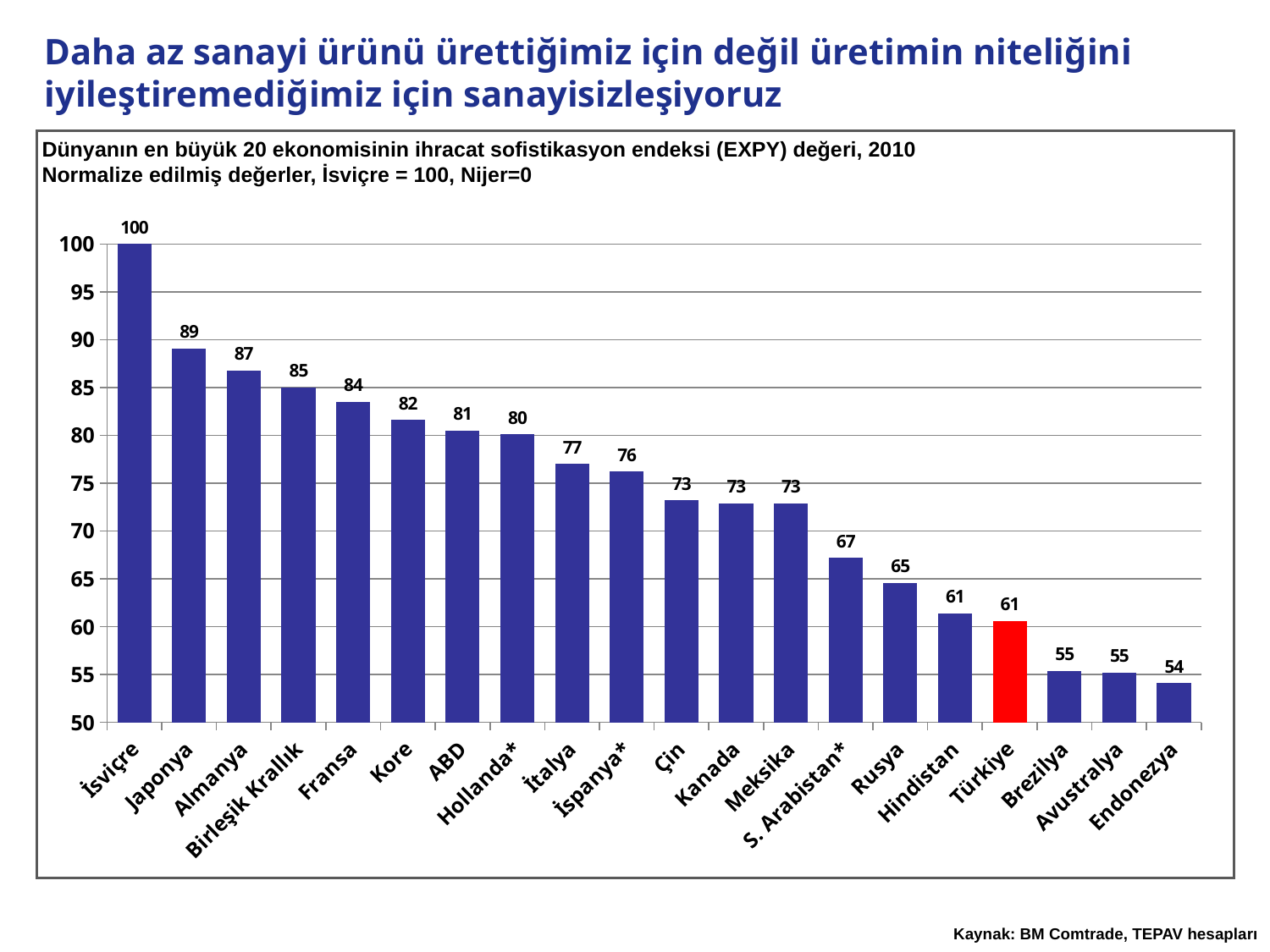
What is the difference between the values for Almanya and Fransa? 3 Which country has the lowest value in the chart? Endonezya What is the value shown for Japonya? 89 What is the difference between the values for İsviçre and Türkiye? 39 What is the EXPY value shown for Türkiye? 61 What is the value shown for Meksika? 73 Is the value for S. Arabistan* greater or less than 70? less Which country has the highest value in the chart? İsviçre What kind of chart is shown on the slide? Bar chart How many countries are shown in the chart? 20 Which has a higher value, Kore or Rusya? Kore Which country's bar is coloured red? Türkiye